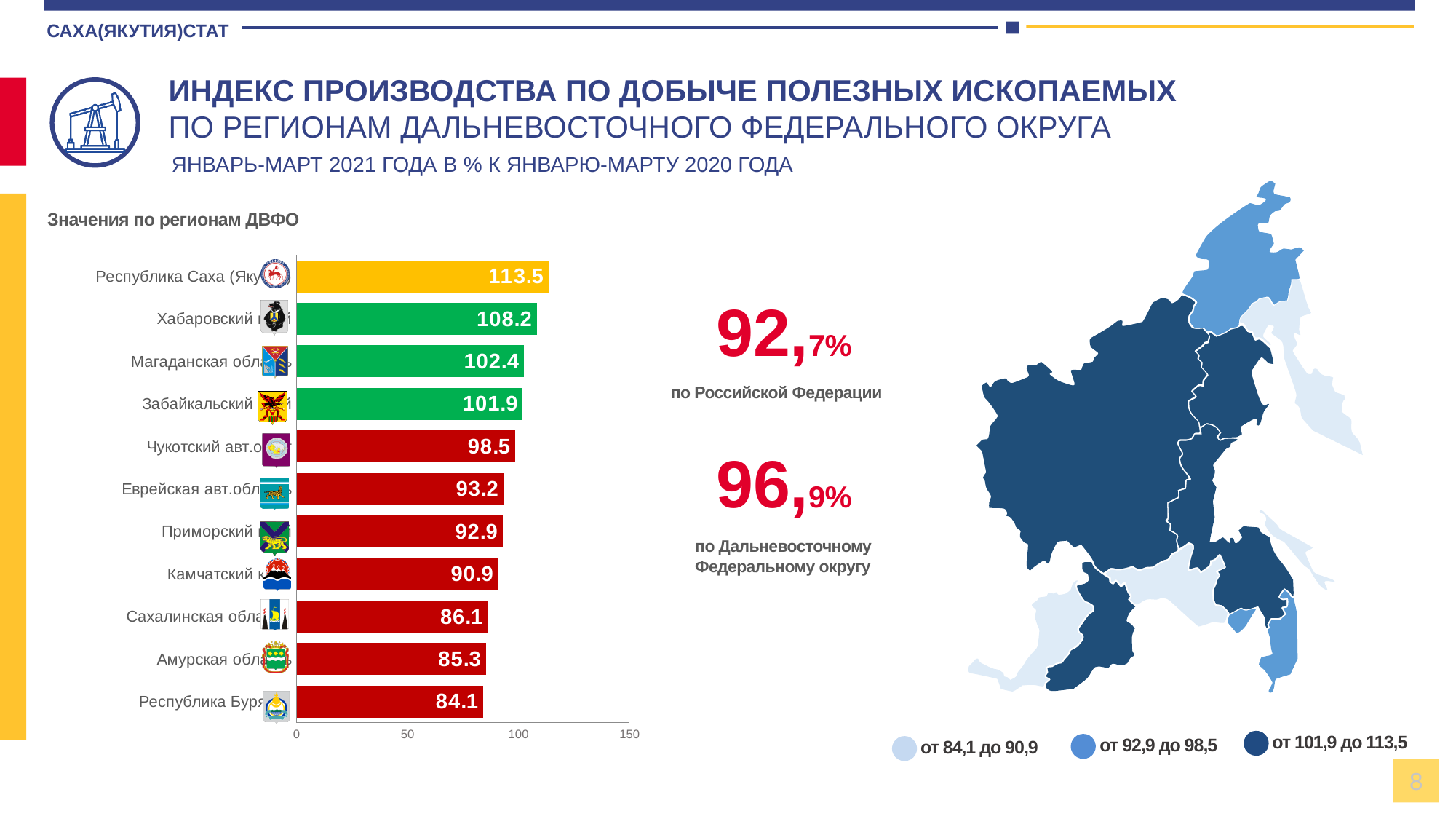
What kind of chart is used to show the values by region? bar chart How many regions are shown in the bar chart? 11 Which region has the highest value in the bar chart? Республика Саха (Якутия) What is the difference between the values for Магаданская область and Забайкальский край? 0.5 What is the value for Хабаровский край in the bar chart? 108.2 What is the value for Сахалинская область in the bar chart? 86.1 What colour are the bars for regions with values below 100? red Which has a larger value, Чукотский авт.округ or Камчатский край? Чукотский авт.округ Which region has the lowest value in the bar chart? Республика Бурятия What is the value for Республика Саха (Якутия) in the bar chart? 113.5 What is the difference between the values for Республика Саха (Якутия) and Республика Бурятия? 29.4 Is the value for Амурская область greater or less than 100? less